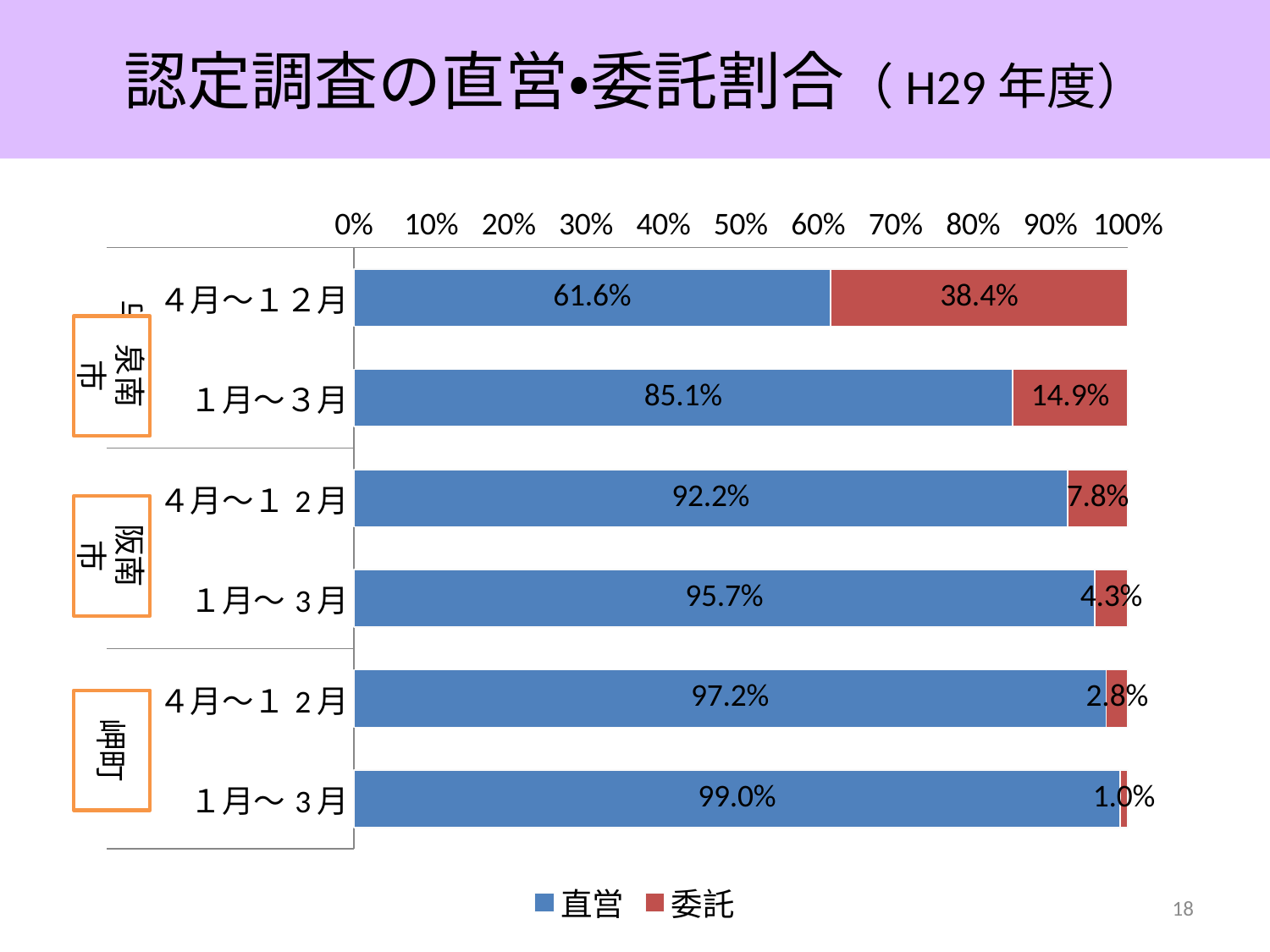
What are the two series named in the legend? 直営 and 委託 How many series does the legend list? 2 How many bars are plotted in the chart? 6 Which bar has the lowest 直営 value? 泉南市 4月～12月 What is the 直営 value for 泉南市 in 4月～12月? 61.6% What type of chart is shown on the slide? Stacked bar chart What is the 委託 value for 阪南市 in 4月～12月? 7.8% Which bar has the highest 委託 value? 泉南市 4月～12月 What is the difference between the 直営 values for 泉南市 in 1月～3月 and 4月～12月? 23.5% What is the 委託 value for 泉南市 in 1月～3月? 14.9%